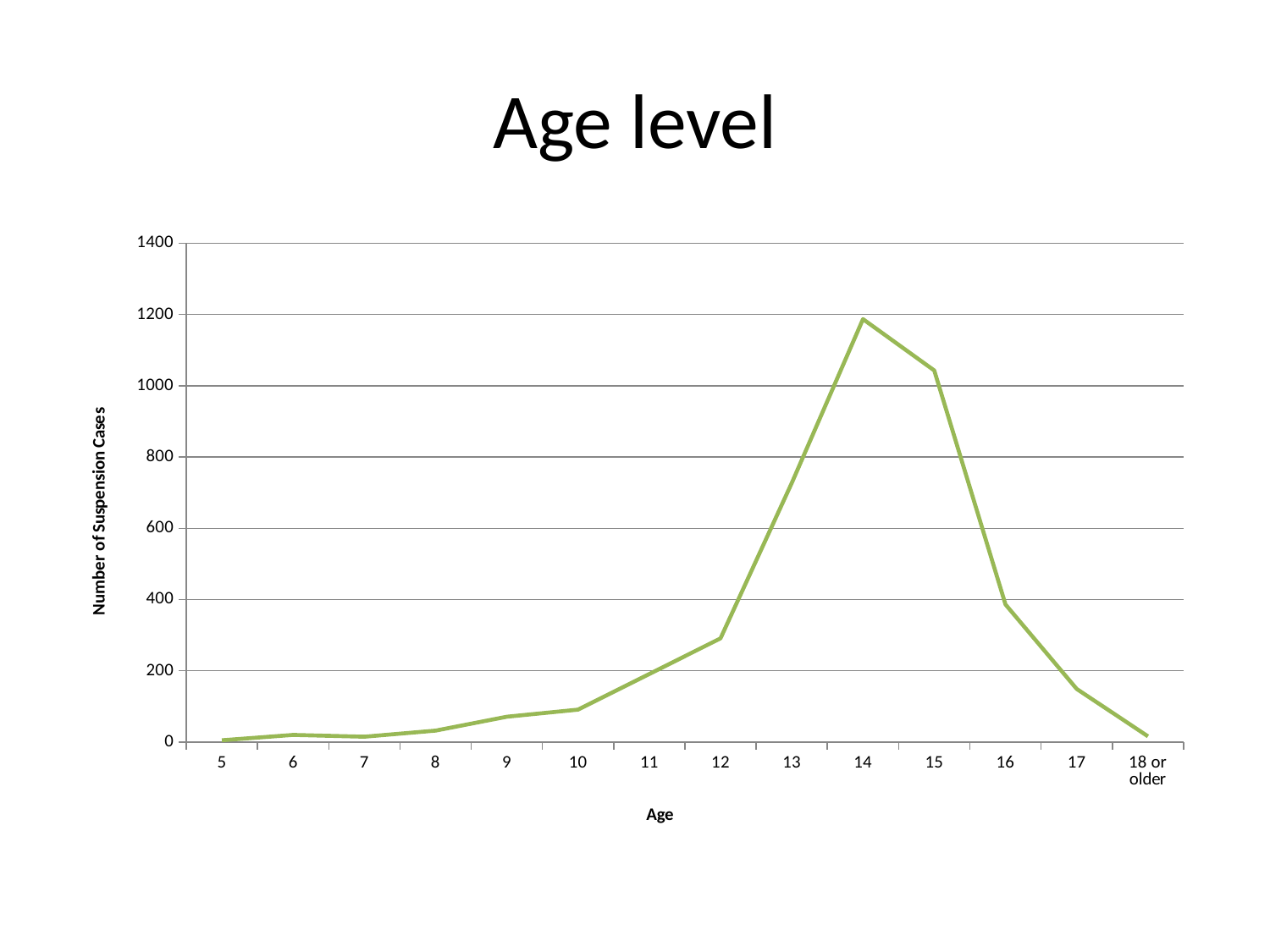
Is the number of suspension cases for age 12 greater or less than 200? greater What kind of chart is shown on the slide? line chart Do the number of suspension cases rise or fall from age 14 to 18 or older? fall Is the number of suspension cases for age 13 greater or less than 600? greater How many age categories are plotted along the x axis? 14 Is the number of suspension cases for age 10 greater or less than 200? less What is the title of the chart? Age level Which age has the highest number of suspension cases? 14 Which has more suspension cases, age 14 or age 15? 14 Which has more suspension cases, age 12 or age 16? 16